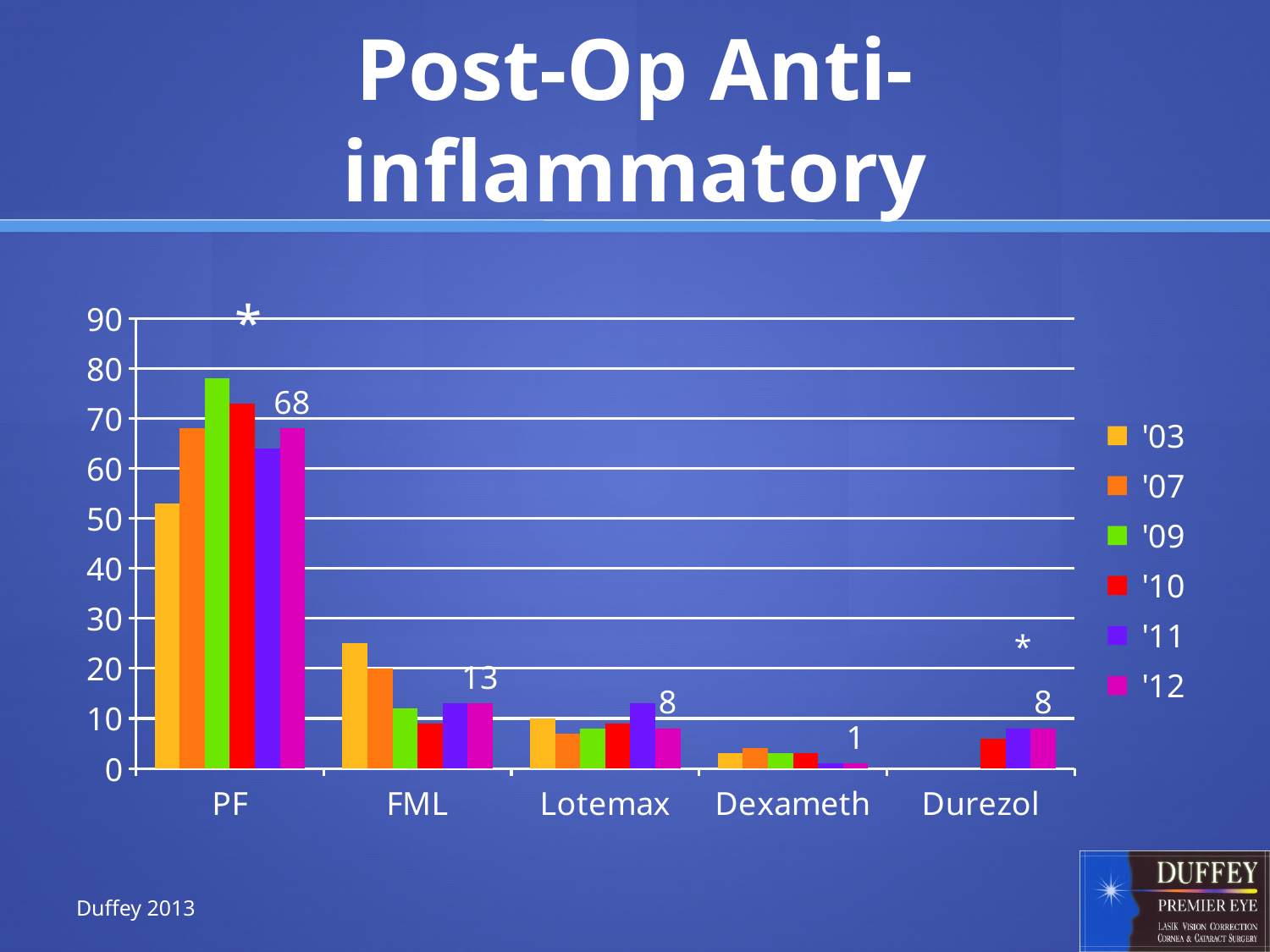
Is the '10 value for Durezol greater or less than 10? less Which category has the lowest '12 value? Dexameth Which is larger, the '03 value for PF or the '03 value for FML? PF How many series does the legend list? 6 Is the '03 value for PF greater or less than 50? greater How many categories are shown on the x axis? 5 What is the value for '12 in the PF category? 68 What is the value for '12 in the Dexameth category? 1 Which category has the highest '12 value? PF What is the value for '12 in the Durezol category? 8 What is the difference between the '12 values for PF and FML? 55 What is the value for '12 in the FML category? 13